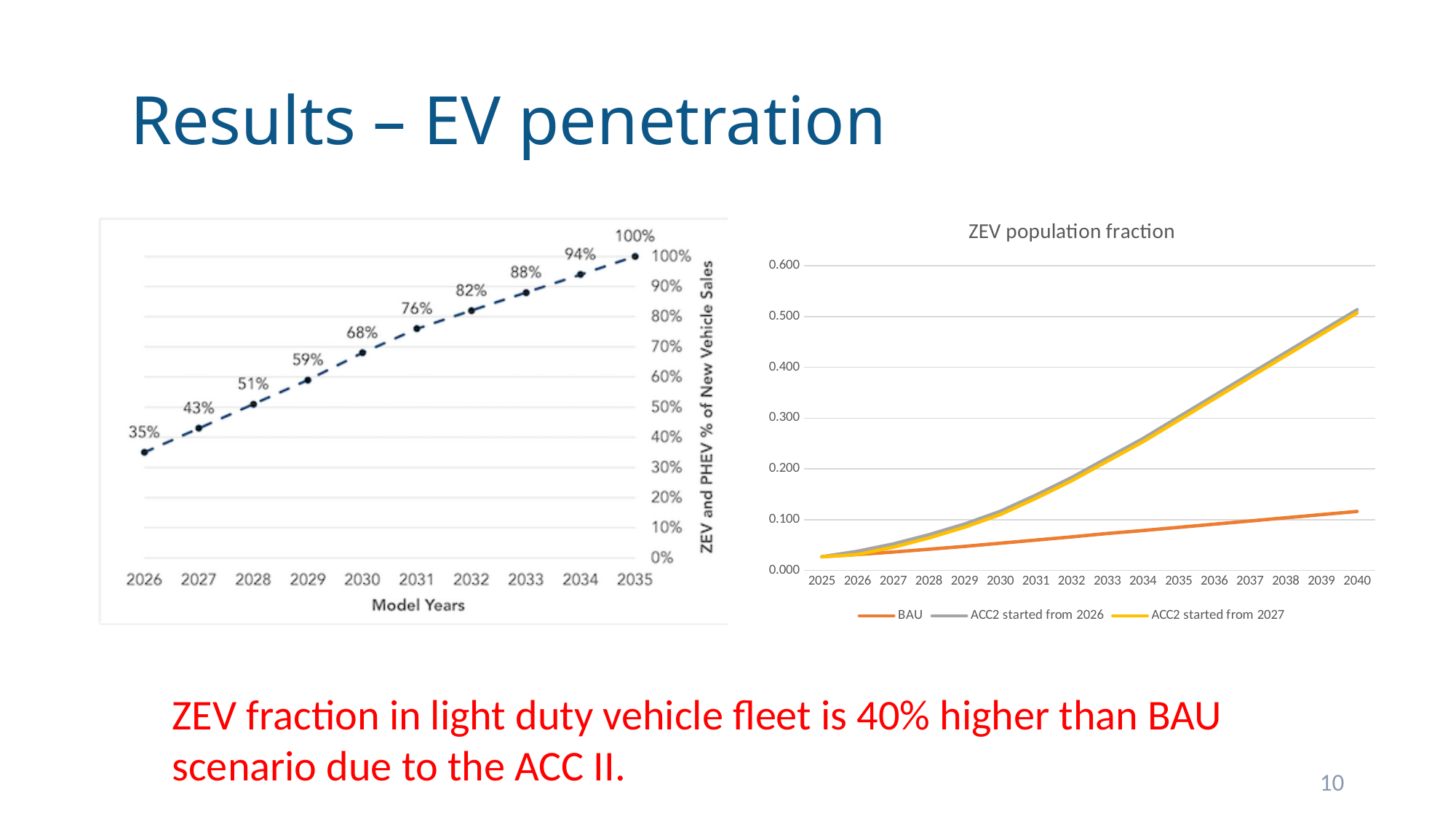
In the left chart, what is the ZEV and PHEV % of new vehicle sales for model year 2030? 68% In the left chart, what is the ZEV and PHEV % of new vehicle sales for model year 2026? 35% In the left chart, which model year has the lowest ZEV and PHEV % of new vehicle sales? 2026 In the left chart, what is the label of the x axis? Model Years In the left chart, which model year has the highest ZEV and PHEV % of new vehicle sales? 2035 In the ZEV population fraction chart, how many series does the legend list? 3 In the left chart, how many model years are plotted? 10 In the ZEV population fraction chart, is the BAU value in 2040 greater or less than 0.200? less In the ZEV population fraction chart, which series is larger in 2035, BAU or ACC2 started from 2027? ACC2 started from 2027 In the ZEV population fraction chart, is the value for ACC2 started from 2026 in 2040 greater or less than 0.400? greater In the left chart, do the values rise or fall from 2026 to 2035? rise In the left chart, what is the difference between the values for model years 2033 and 2028? 37%